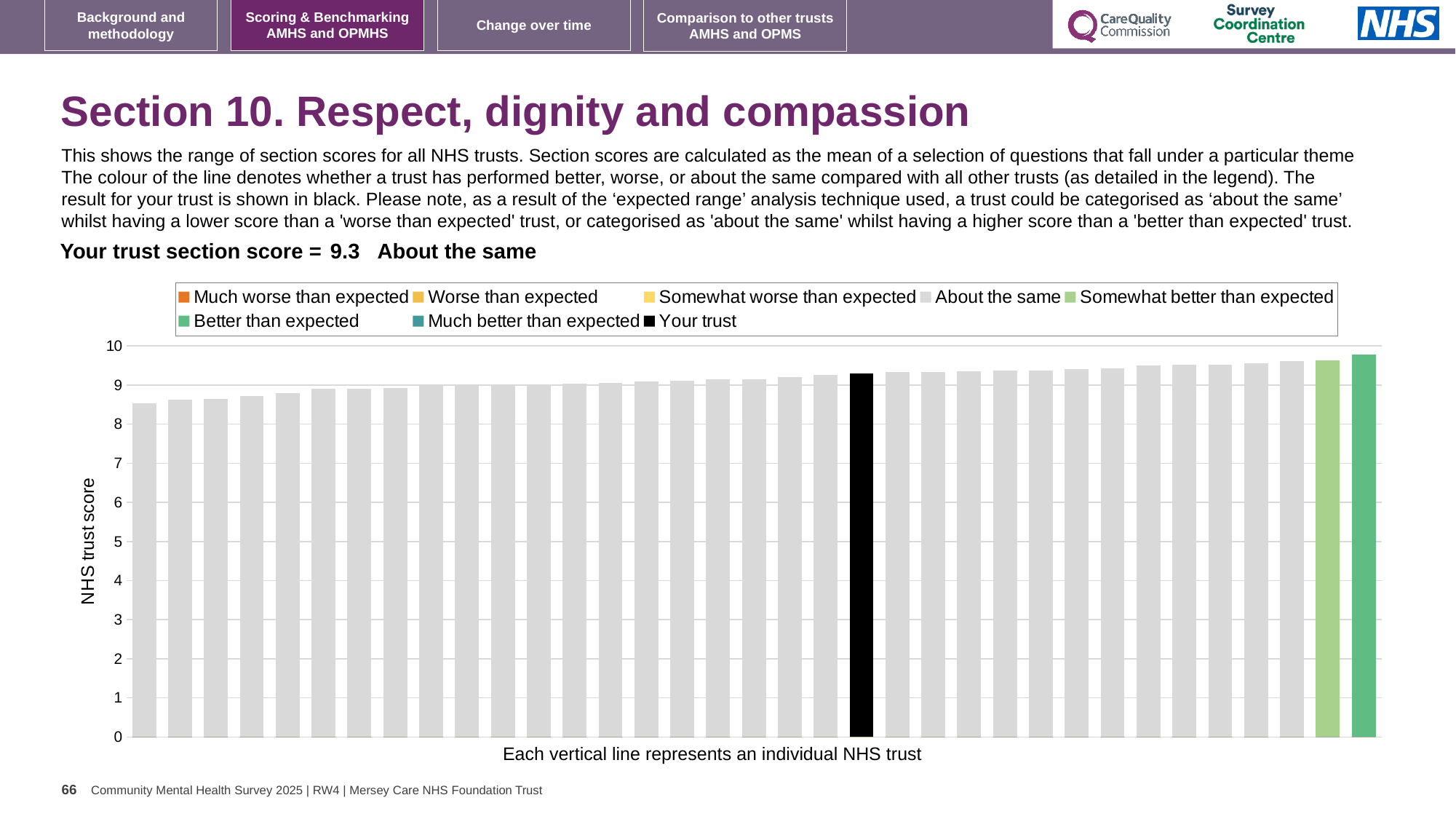
What does the text below the x axis say each vertical line represents? an individual NHS trust What kind of chart is shown on the slide? bar chart Is the value of the tallest bar (rightmost) greater or less than 10? less What is the section score for your trust shown on the slide? 9.3 Do the bar values rise or fall from left to right along the x axis? rise Is the value of the shortest bar (leftmost) greater or less than 8? greater Which performance category is your trust placed in for this section? About the same Is the value of the black bar greater or less than 9? greater How many entries does the chart legend list? 8 How many bars are coloured black for 'Your trust'? 1 Which legend category does the tallest bar belong to? Better than expected What is the label on the vertical axis of the chart? NHS trust score